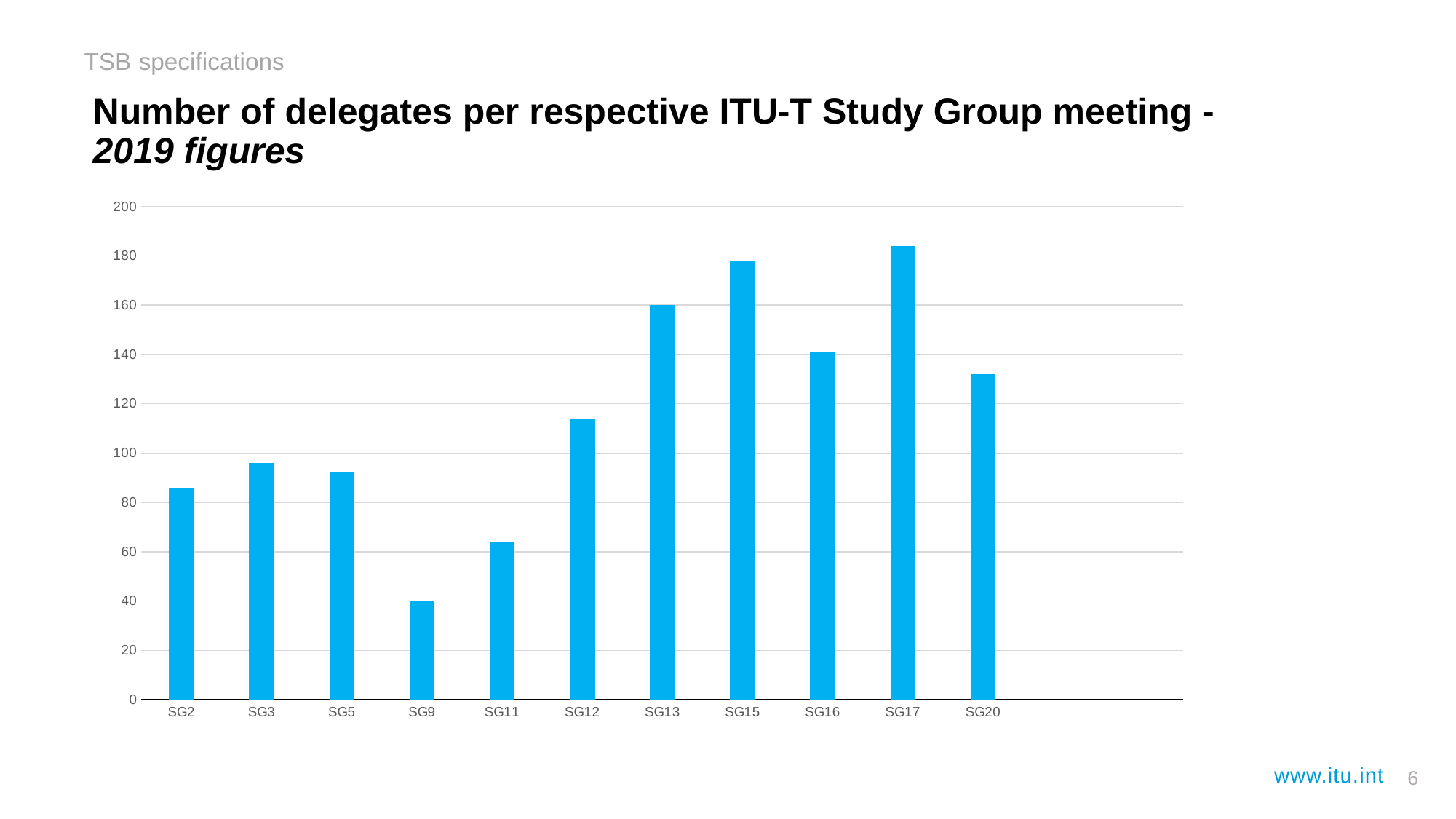
Which Study Group has the highest number of delegates? SG17 Is the value for SG12 greater or less than 100? greater What is the number of delegates for SG9? 40 What kind of chart is shown on the slide? bar chart Is the value for SG20 greater or less than 120? greater What is the title of the chart on the slide? Number of delegates per respective ITU-T Study Group meeting - 2019 figures Which Study Group has the lowest number of delegates? SG9 How many Study Groups are shown on the x axis of the chart? 11 Is the value for SG2 greater or less than 100? less What is the number of delegates for SG13? 160 Which has more delegates, SG13 or SG16? SG13